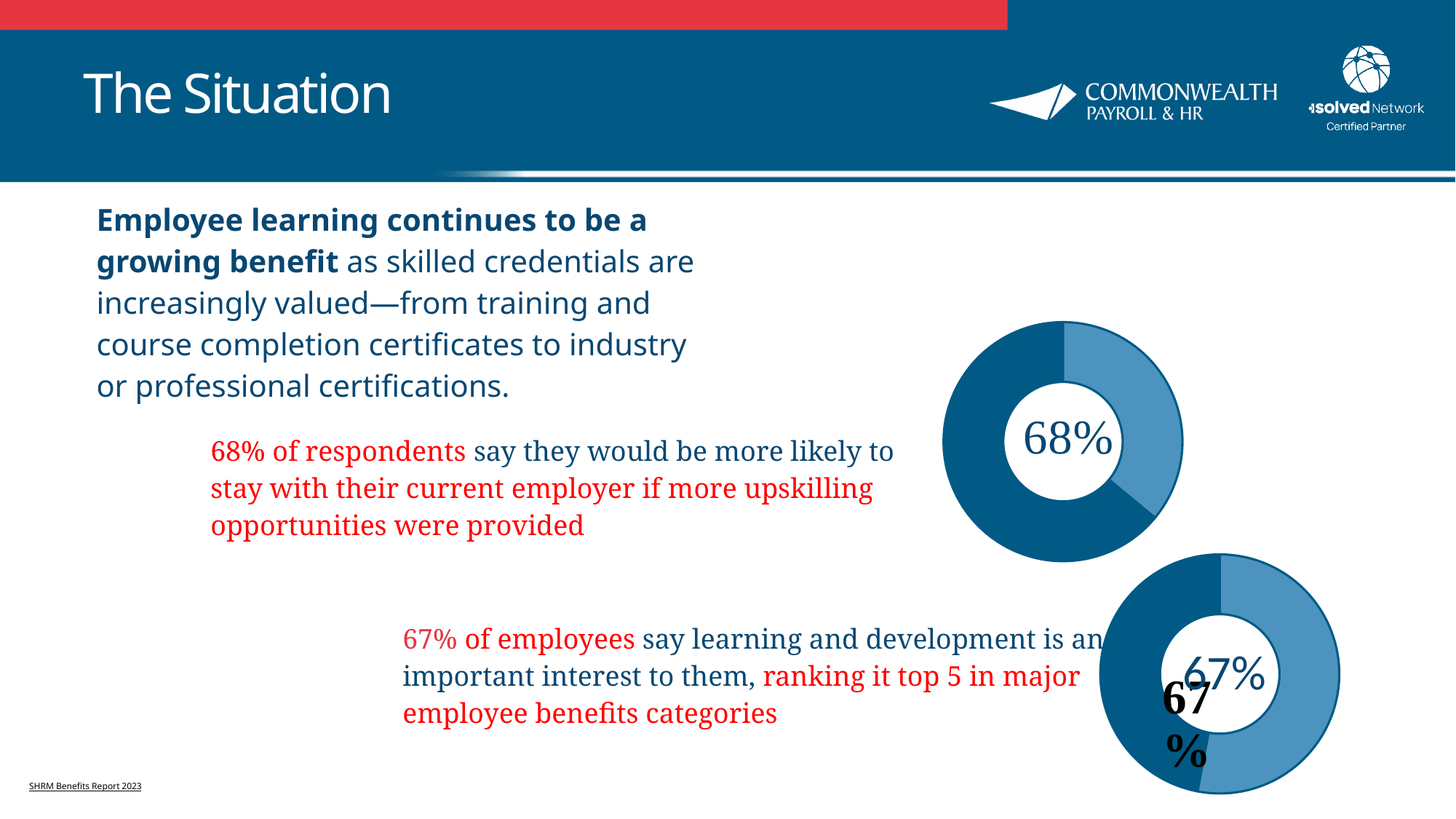
How many slices does the upper donut chart have? 2 What kind of chart is the upper chart on the right side of the slide? Donut chart What percentage is printed in the centre of the lower donut chart? 67% What percentage is printed in the centre of the upper donut chart? 68% In the upper donut chart, which slice is larger, the dark blue one or the light blue one? Dark blue Is the value shown in the centre of the lower donut chart greater or less than 50%? greater Which donut chart shows the higher percentage in its centre, the upper one or the lower one? The upper one (68%) What two colours are used for the slices of the donut charts? Dark blue and light blue Is the value shown in the centre of the upper donut chart greater or less than 50%? greater How many slices does the lower donut chart have? 2 What kind of chart is the lower chart at the bottom right of the slide? Donut chart What is the difference between the percentage shown in the upper donut chart and the percentage shown in the lower donut chart? 1%